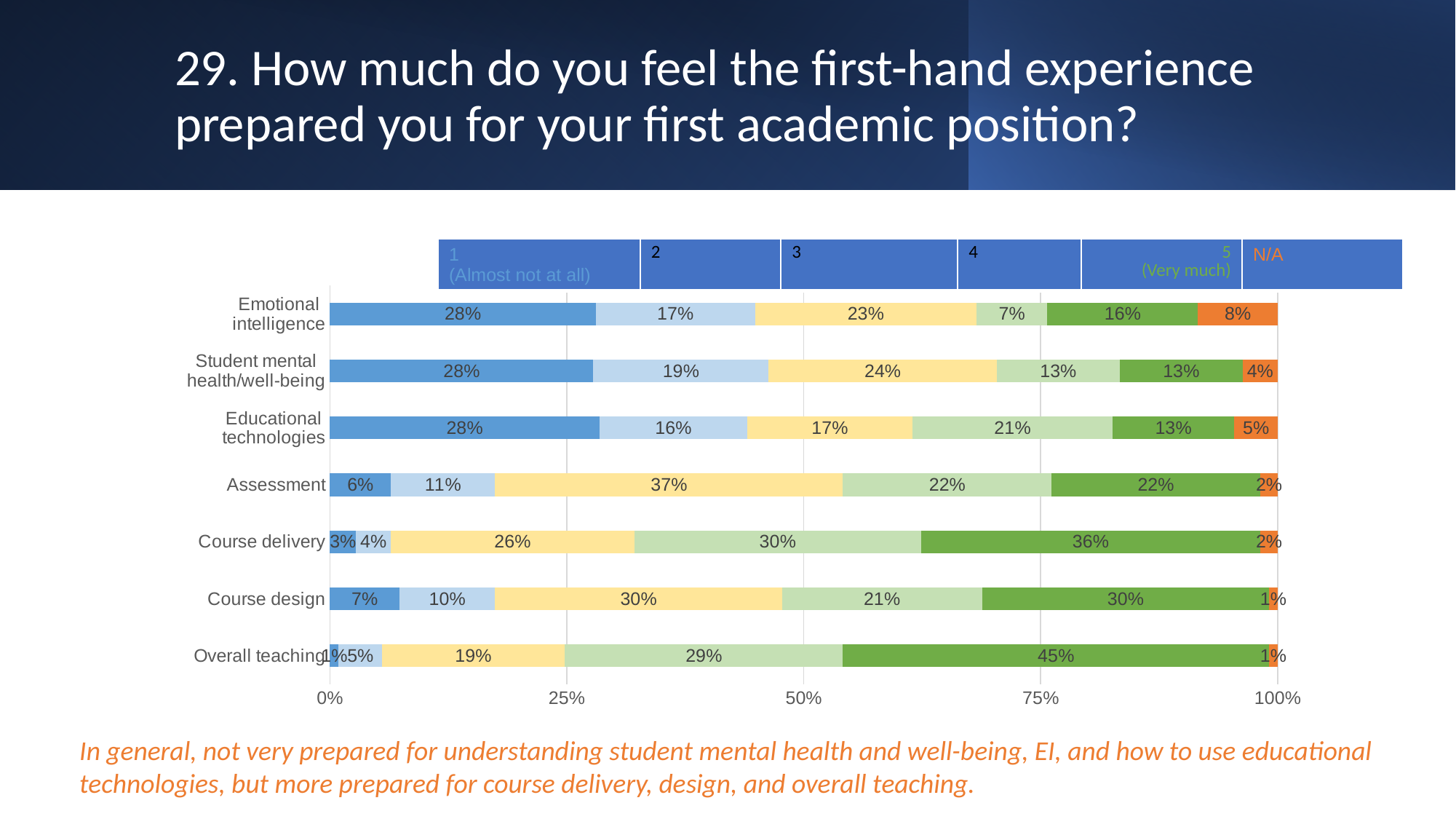
Which category has the lowest percentage for the 1 (Almost not at all) rating? Overall teaching What is the N/A percentage for Emotional intelligence? 8% Which has a larger percentage for the rating of 3: Student mental health/well-being or Educational technologies? Student mental health/well-being Which category has the highest percentage for the 5 (Very much) rating? Overall teaching What percentage of respondents rated Overall teaching as 5 (Very much)? 45% How many series does the legend list? 6 Which category has the highest N/A percentage? Emotional intelligence What is the difference in percentage points between the 5 (Very much) rating for Course delivery and for Emotional intelligence? 20 percentage points How many categories are shown on the chart? 7 What percentage of respondents gave Assessment a rating of 3? 37% What label does the legend give to the rating of 5? Very much What kind of chart is shown on the slide? Stacked bar chart